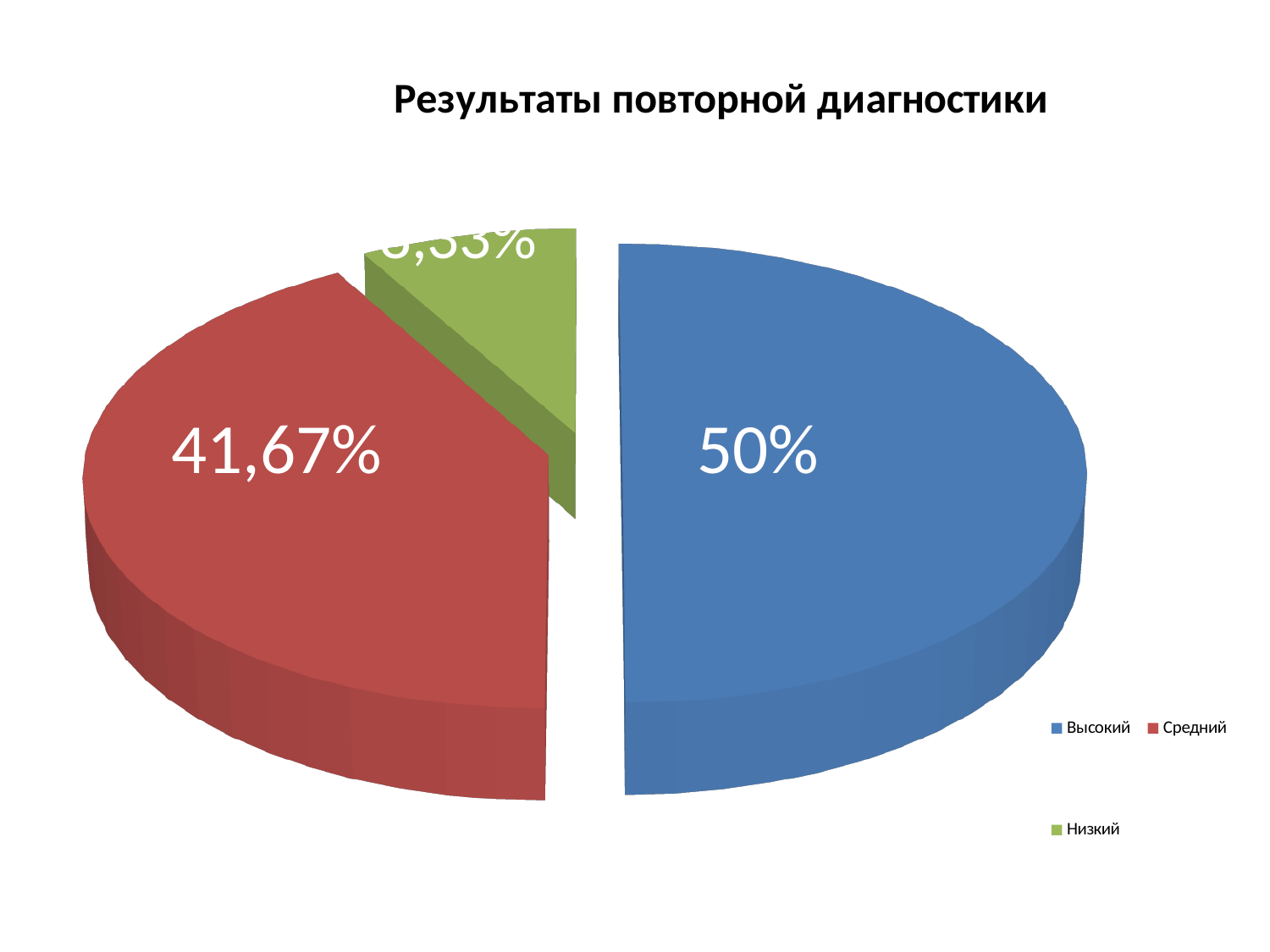
How many entries does the legend list? 3 What colour is the Средний slice? Red Which slice is larger, Высокий or Средний? Высокий What is the difference between the Высокий and Средний shares? 8,33% Which category has the smallest slice of the pie? Низкий What type of chart is shown on the slide? Pie chart Which slice is larger, Средний or Низкий? Средний What is the title of the chart? Результаты повторной диагностики What share of the pie does the Высокий slice have? 50% How many slices does the pie chart have? 3 Which category has the largest slice of the pie? Высокий What share of the pie does the Средний slice have? 41,67%